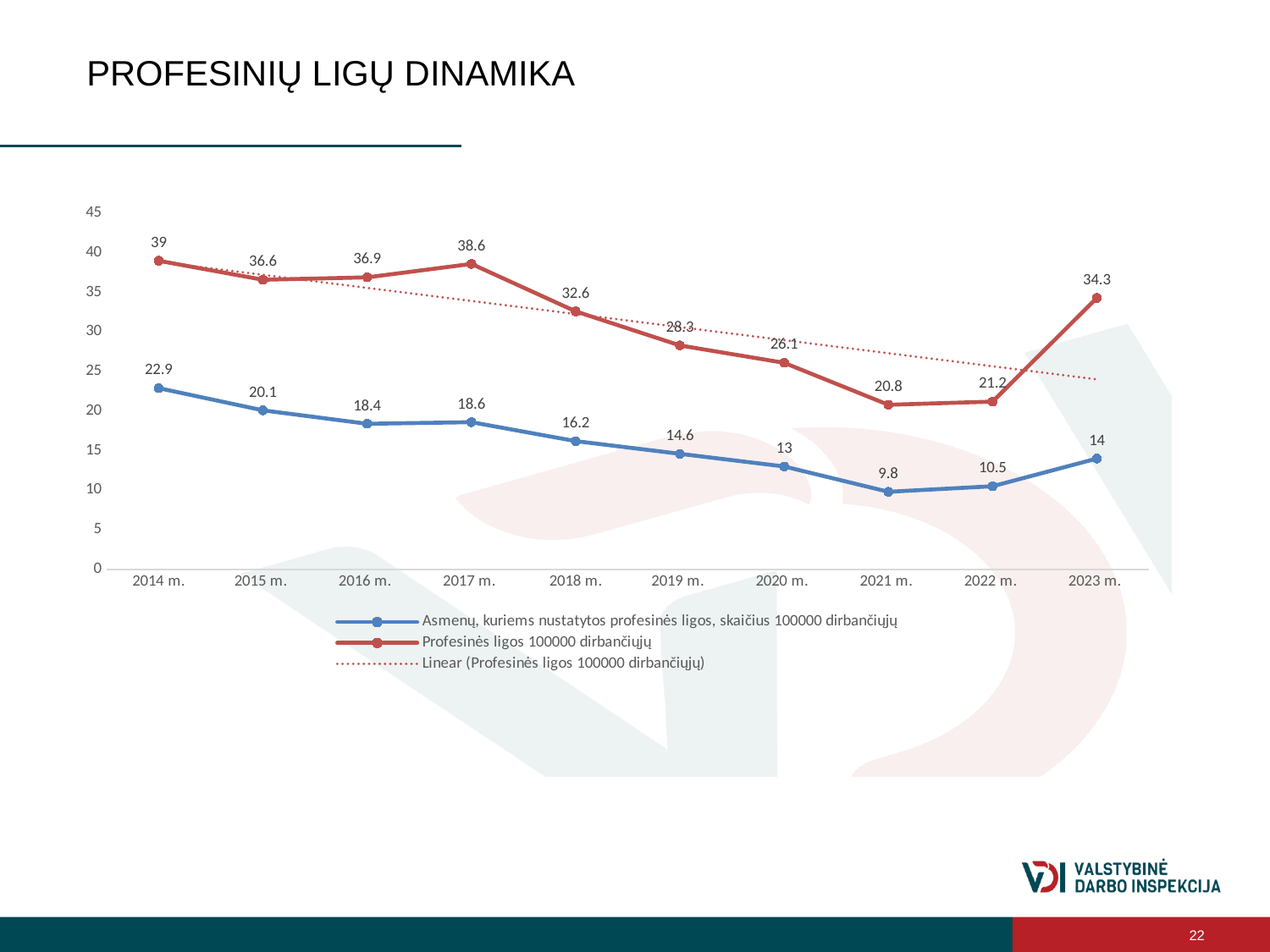
What is the value of 'Profesinės ligos 100000 dirbančiųjų' in 2023 m.? 34.3 What type of chart is shown on the slide? line chart What is the value of 'Asmenų, kuriems nustatytos profesinės ligos, skaičius 100000 dirbančiųjų' in 2021 m.? 9.8 How many entries does the legend list? 3 How many years are shown on the x axis? 10 What is the value of 'Profesinės ligos 100000 dirbančiųjų' in 2014 m.? 39 What is the title of the slide? PROFESINIŲ LIGŲ DINAMIKA What is the difference between the 'Profesinės ligos 100000 dirbančiųjų' values for 2023 m. and 2022 m.? 13.1 In which year is 'Profesinės ligos 100000 dirbančiųjų' lowest? 2021 m. Which is larger: the 'Asmenų, kuriems nustatytos profesinės ligos, skaičius 100000 dirbančiųjų' value in 2016 m. or in 2017 m.? 2017 m. In which year is 'Asmenų, kuriems nustatytos profesinės ligos, skaičius 100000 dirbančiųjų' highest? 2014 m. Does 'Profesinės ligos 100000 dirbančiųjų' generally rise or fall from 2014 m. to 2021 m.? fall